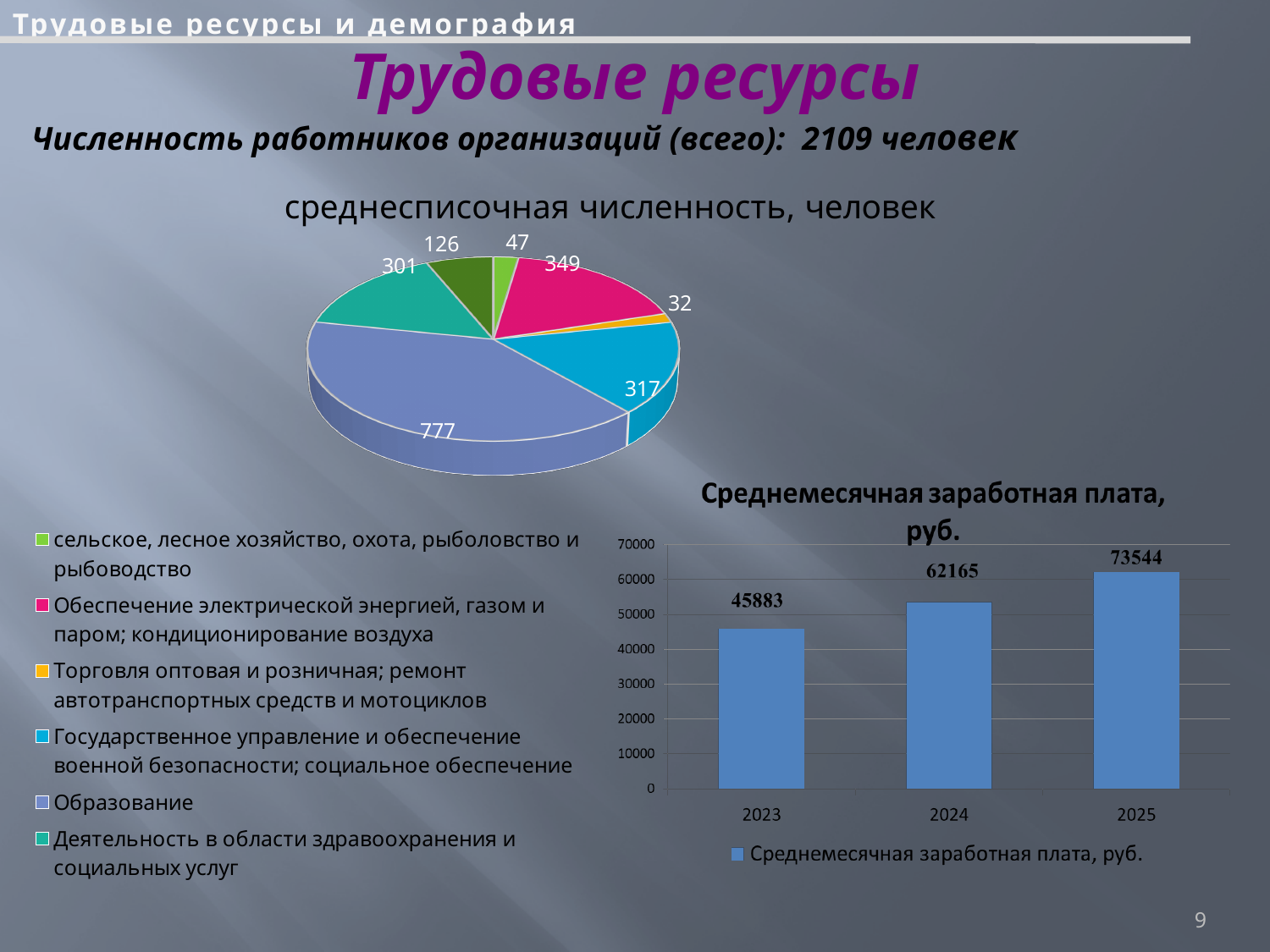
In the pie chart 'среднесписочная численность, человек', which is larger: Обеспечение электрической энергией, газом и паром; кондиционирование воздуха or Деятельность в области здравоохранения и социальных услуг? Обеспечение электрической энергией, газом и паром; кондиционирование воздуха In the pie chart 'среднесписочная численность, человек', what is the value for Образование? 777 In the bar chart 'Среднемесячная заработная плата, руб.', what is the value for 2024? 62165 What kind of chart is the chart titled 'среднесписочная численность, человек'? pie chart In the pie chart 'среднесписочная численность, человек', what is the value for Торговля оптовая и розничная; ремонт автотранспортных средств и мотоциклов? 32 In the bar chart 'Среднемесячная заработная плата, руб.', do the values rise or fall from 2023 to 2025? rise In the bar chart 'Среднемесячная заработная плата, руб.', what is the difference between the values for 2025 and 2023? 27661 In the pie chart 'среднесписочная численность, человек', which category has the largest slice? Образование In the pie chart 'среднесписочная численность, человек', what is the difference between the values for Образование and Деятельность в области здравоохранения и социальных услуг? 476 How many years are shown on the x axis of the bar chart 'Среднемесячная заработная плата, руб.'? 3 In the pie chart 'среднесписочная численность, человек', what is the value for Государственное управление и обеспечение военной безопасности; социальное обеспечение? 317 In the pie chart 'среднесписочная численность, человек', which category has the smallest slice? Торговля оптовая и розничная; ремонт автотранспортных средств и мотоциклов